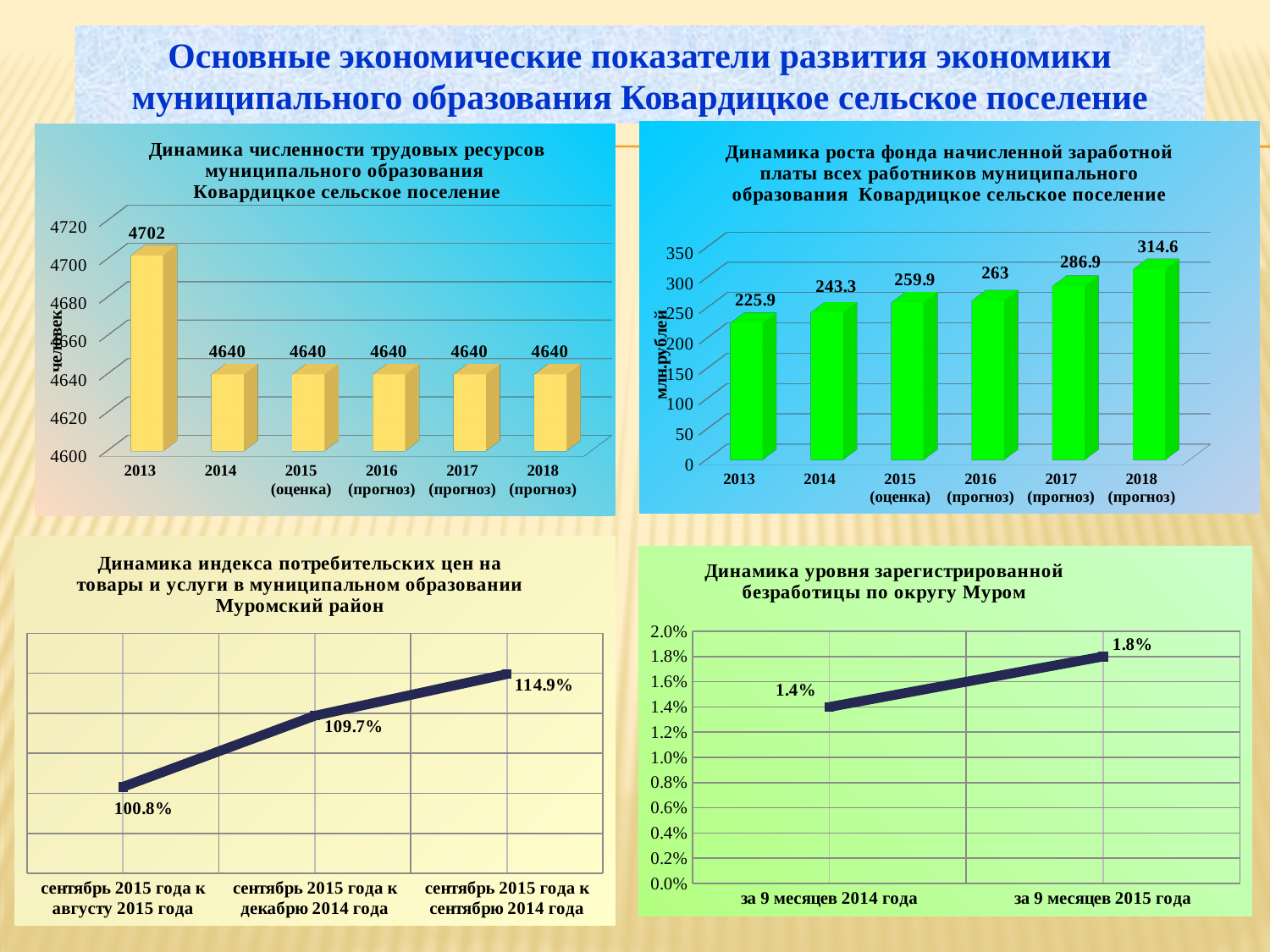
In the bottom-left chart (Динамика индекса потребительских цен), what is the value for сентябрь 2015 года к декабрю 2014 года? 109.7% What kind of chart is the bottom-left chart (Динамика индекса потребительских цен)? line chart In the top-right chart (Динамика роста фонда начисленной заработной платы), what is the value for 2018 (прогноз)? 314.6 In the top-left chart (Динамика численности трудовых ресурсов), which year has the highest value? 2013 In the top-left chart (Динамика численности трудовых ресурсов), how many bars are plotted? 6 In the top-right chart (Динамика роста фонда начисленной заработной платы), do the values rise or fall from 2013 to 2018? rise In the top-right chart (Динамика роста фонда начисленной заработной платы), what is the difference between the 2017 (прогноз) value and the 2016 (прогноз) value? 23.9 In the bottom-right chart (Динамика уровня зарегистрированной безработицы), which is larger: the value for за 9 месяцев 2014 года or за 9 месяцев 2015 года? за 9 месяцев 2015 года In the top-right chart (Динамика роста фонда начисленной заработной платы), which year has the lowest value? 2013 In the top-left chart (Динамика численности трудовых ресурсов), what is the value for 2013? 4702 What kind of chart is the top-right chart (Динамика роста фонда начисленной заработной платы)? bar chart In the top-left chart (Динамика численности трудовых ресурсов), what is the difference between the 2013 value and the 2014 value? 62